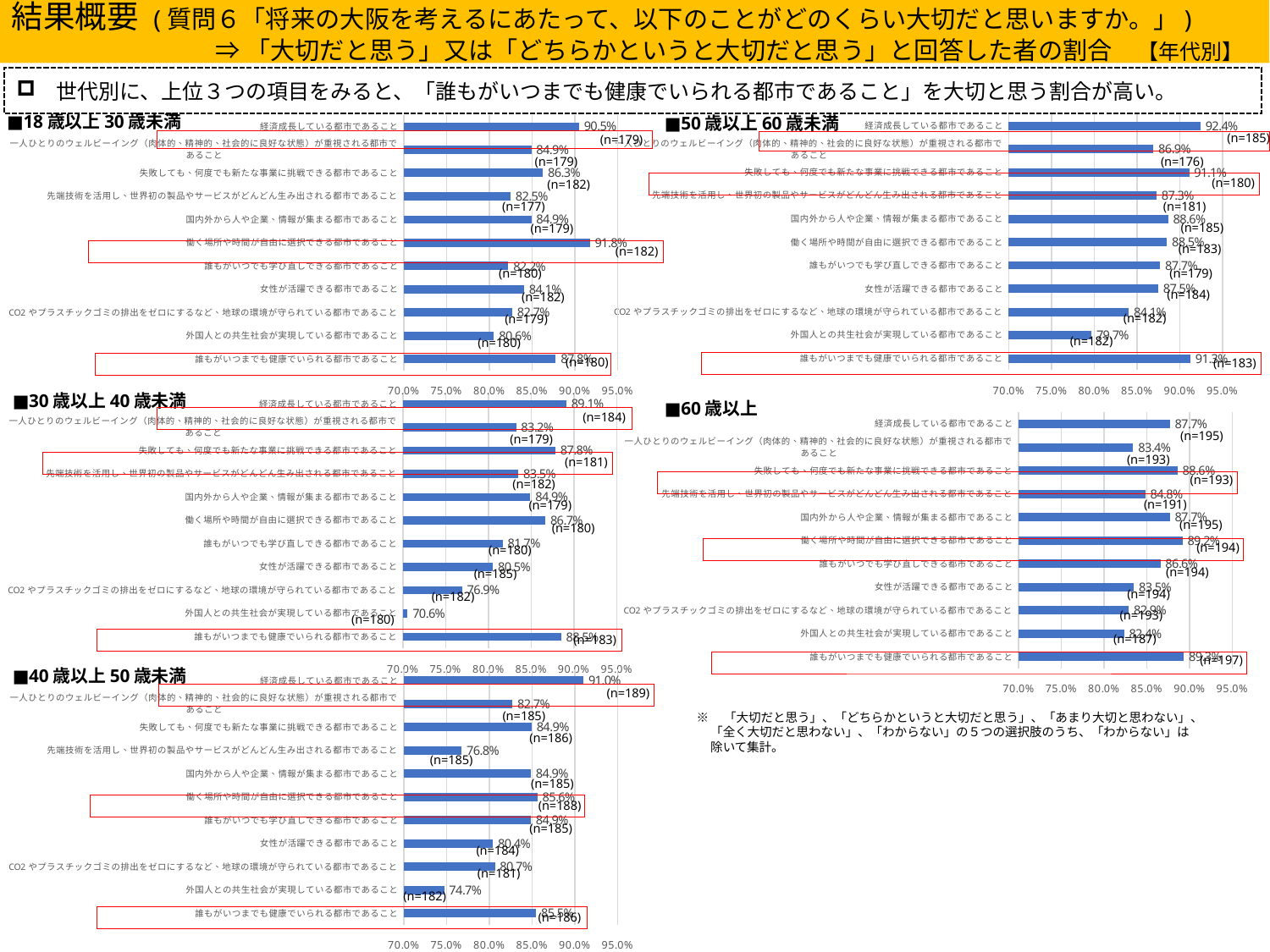
In the 「60歳以上」 chart, what is the value for 「誰もがいつまでも健康でいられる都市であること」? 89.3% In the 「30歳以上40歳未満」 chart, what is the value for 「外国人との共生社会が実現している都市であること」? 70.6% In the 「18歳以上30歳未満」 chart, which item has the lowest value? 外国人との共生社会が実現している都市であること In the 「18歳以上30歳未満」 chart, what is the value for 「働く場所や時間が自由に選択できる都市であること」? 91.8% In the 「40歳以上50歳未満」 chart, what is the difference between 「経済成長している都市であること」 and 「先端技術を活用し、世界初の製品やサービスがどんどん生み出される都市であること」? 14.2 percentage points What type of chart is used for each age group on this slide? Bar chart In the 「40歳以上50歳未満」 chart, which is larger: 「働く場所や時間が自由に選択できる都市であること」 or 「女性が活躍できる都市であること」? 働く場所や時間が自由に選択できる都市であること In the 「60歳以上」 chart, what is the sample size (n) for 「誰もがいつまでも健康でいられる都市であること」? n=197 In the 「50歳以上60歳未満」 chart, is the value for 「外国人との共生社会が実現している都市であること」 greater or less than 80.0%? less How many items (categories) are plotted in the 「60歳以上」 chart? 11 In the 「50歳以上60歳未満」 chart, what is the value for 「経済成長している都市であること」? 92.4% In the 「30歳以上40歳未満」 chart, which item has the highest value? 経済成長している都市であること